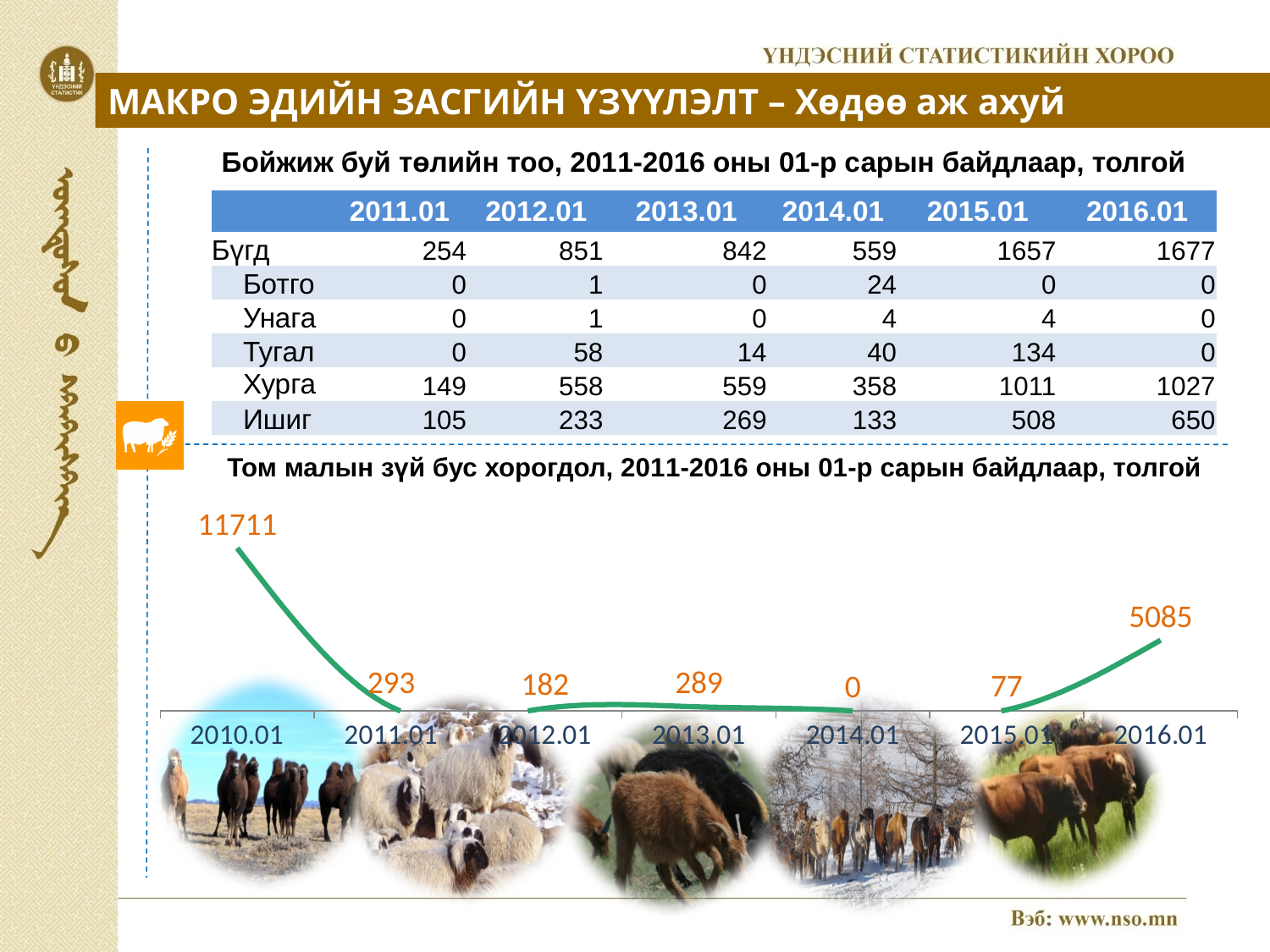
What is the title of the line chart? Том малын зүй бус хорогдол, 2011-2016 оны 01-р сарын байдлаар, толгой In the line chart, what is the value for 2010.01? 11711 In the line chart, what is the value for 2016.01? 5085 What type of chart is shown at the bottom of the slide? line chart How many data points are plotted in the line chart? 7 In the line chart, do the values rise or fall from 2010.01 to 2011.01? fall In the line chart, which period has the highest value? 2010.01 In the line chart, what is the value for 2012.01? 182 In the line chart, which period has the lowest value? 2014.01 In the line chart, which is larger, the value for 2011.01 or the value for 2013.01? 2011.01 In the line chart, what is the value for 2014.01? 0 In the line chart, what is the difference between the values for 2010.01 and 2016.01? 6626